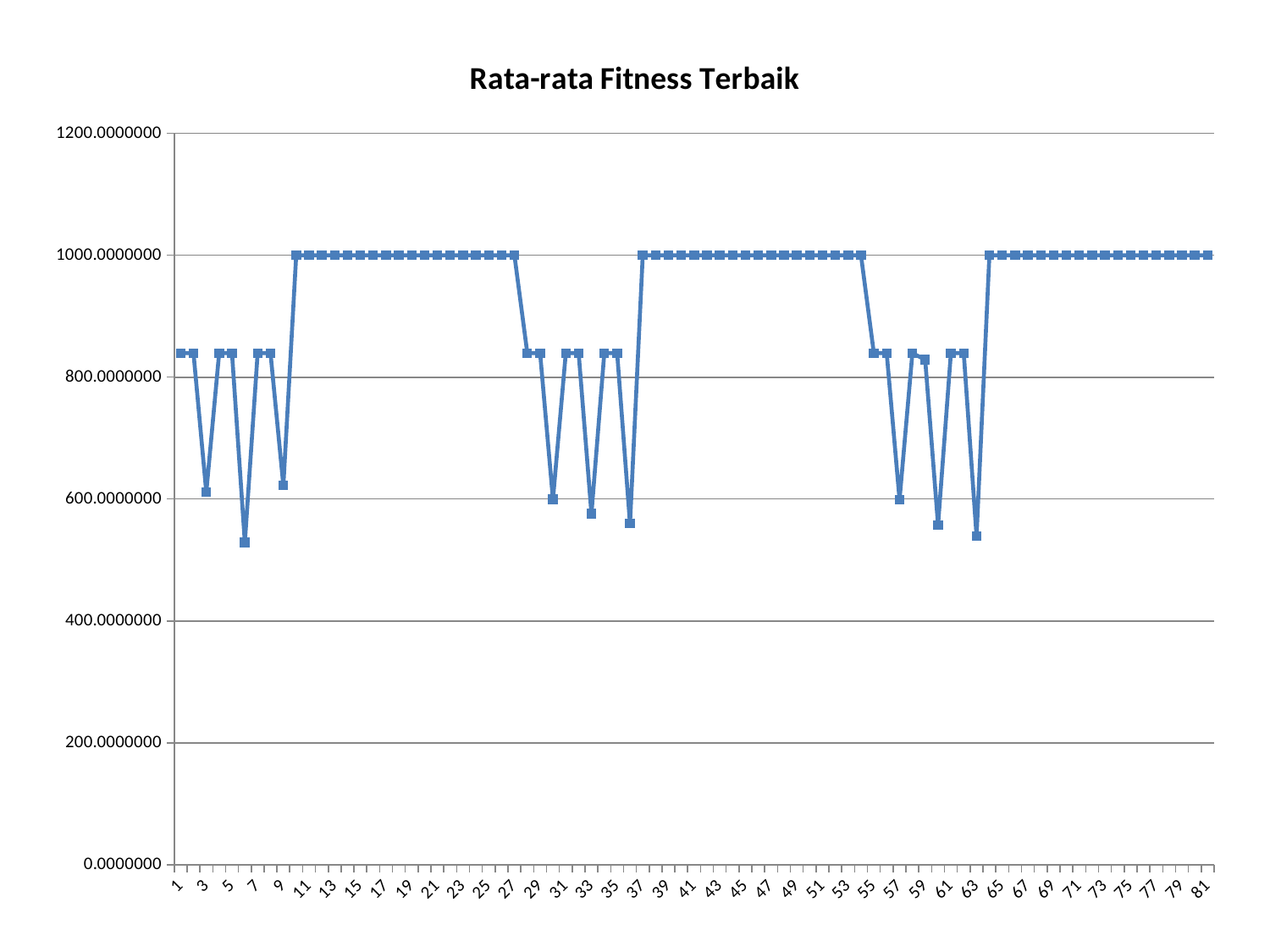
Is the value at x = 3 greater or less than 800? less Between x = 11 and x = 27, do the values rise, fall, or stay flat? stay flat What is the title of the chart? Rata-rata Fitness Terbaik What is the value at x = 81? 1000.0000000 Is the value at x = 1 greater or less than 800? greater Is the value at x = 40 greater or less than 800? greater What is the highest value shown on the y axis? 1200.0000000 Which is larger, the value at x = 20 or the value at x = 30? x = 20 What kind of chart is shown on the slide? line chart